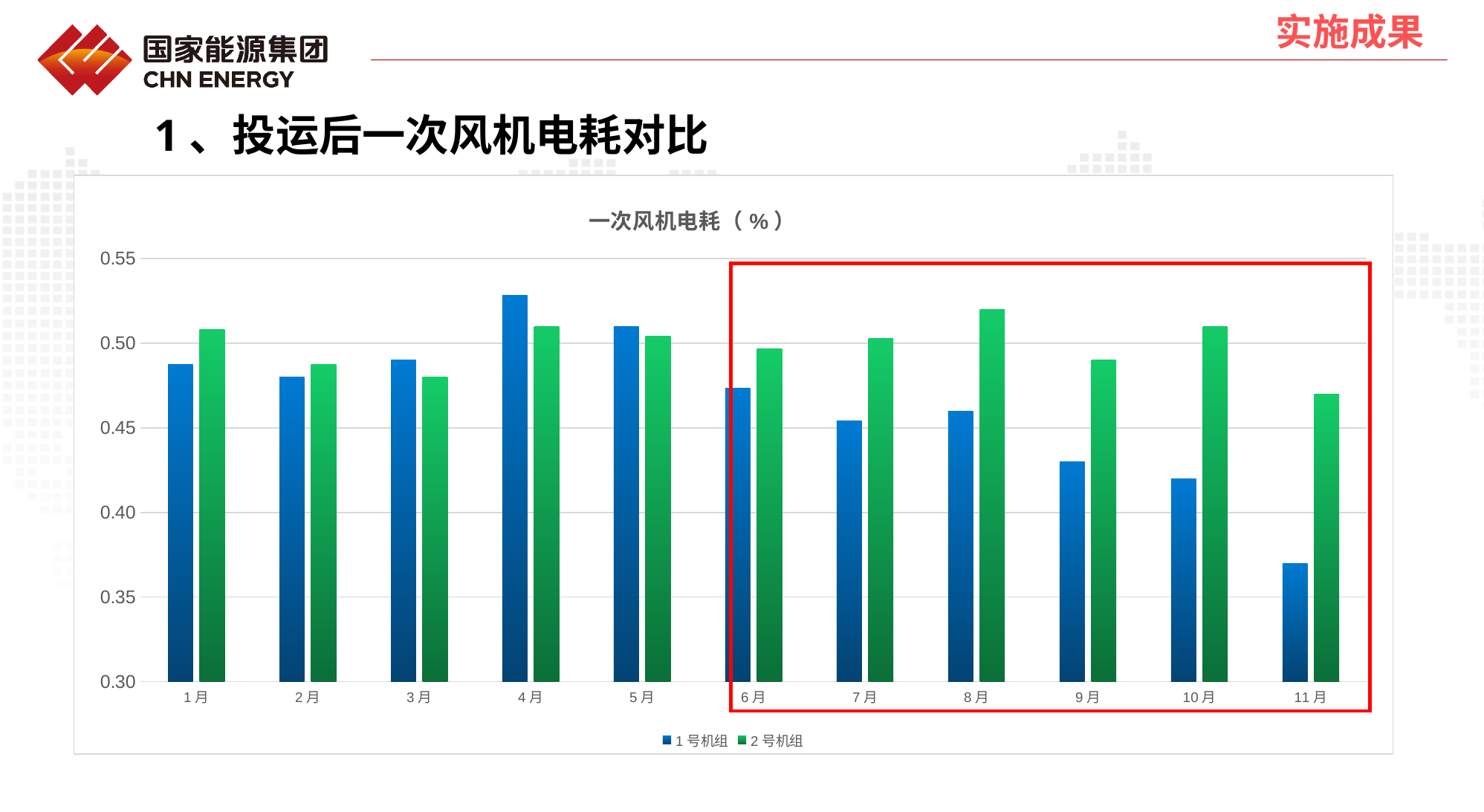
How many months are shown on the x axis? 11 Is the value for 1 号机组 in 4 月 greater or less than 0.50? greater In which month is the value for 1 号机组 lowest? 11 月 What kind of chart is shown on the slide? bar chart How many series does the legend list? 2 In which month is the value for 2 号机组 highest? 8 月 In 11 月, which series has the larger value, 1 号机组 or 2 号机组? 2 号机组 What is the title of the chart? 一次风机电耗（%） In which month is the value for 1 号机组 highest? 4 月 Which series is shown in green in the legend? 2 号机组 From 6 月 to 11 月, do the values for 1 号机组 generally rise or fall? fall Is the value for 1 号机组 in 11 月 greater or less than 0.40? less